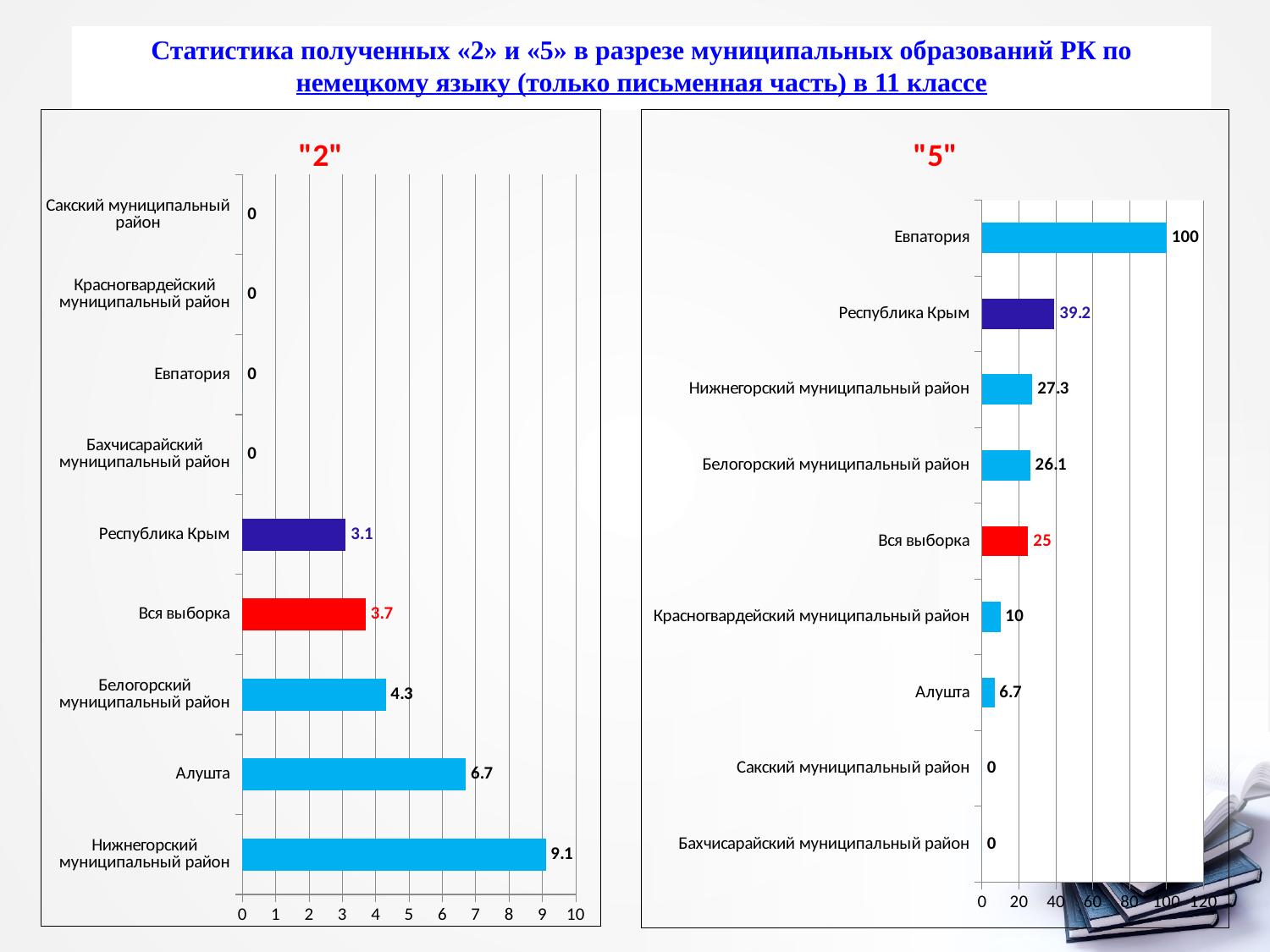
In the "5" chart, what colour is the bar for Вся выборка? Red In the "5" chart, which category has the highest value? Евпатория In the "5" chart, which is larger, the value for Нижнегорский муниципальный район or Вся выборка? Нижнегорский муниципальный район In the "5" chart, what is the value for Республика Крым? 39.2 In the "2" chart, what is the value for Нижнегорский муниципальный район? 9.1 In the "2" chart, which category has the highest value? Нижнегорский муниципальный район In the "2" chart, what is the value for Вся выборка? 3.7 In the "2" chart, what is the difference between the values for Алушта and Республика Крым? 3.6 In the "5" chart, what is the difference between the values for Евпатория and Республика Крым? 60.8 What kind of chart is the "5" chart? Bar chart In the "2" chart, how many categories are shown? 9 In the "5" chart, what is the value for Красногвардейский муниципальный район? 10